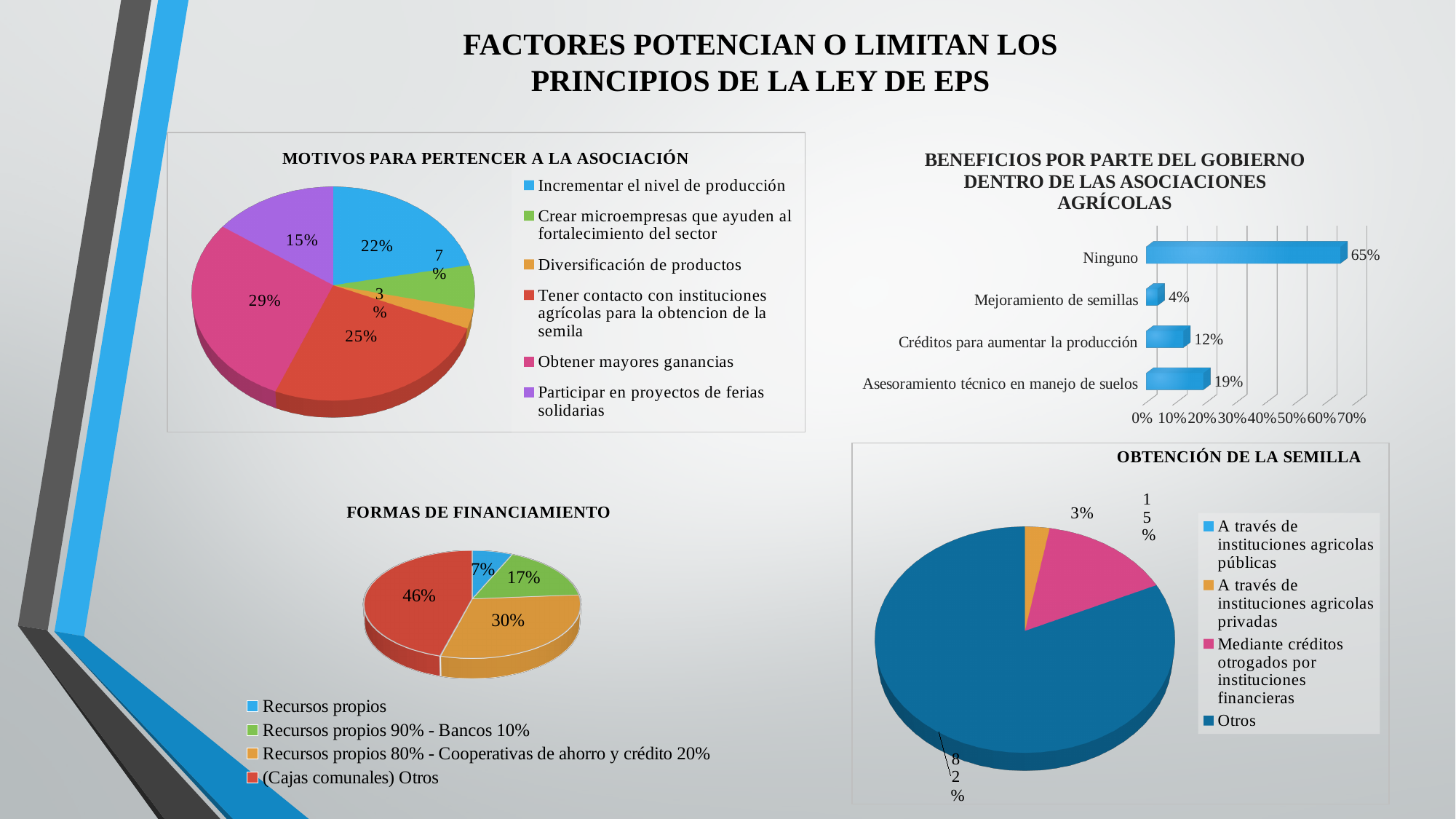
In the 'BENEFICIOS POR PARTE DEL GOBIERNO' chart, what is the value for 'Ninguno'? 65% In the 'MOTIVOS PARA PERTENCER A LA ASOCIACIÓN' chart, what is the difference between the shares for 'Incrementar el nivel de producción' and 'Participar en proyectos de ferias solidarias'? 7% In the 'OBTENCIÓN DE LA SEMILLA' chart, what percentage is shown for 'Otros'? 82% In the 'BENEFICIOS POR PARTE DEL GOBIERNO' chart, which is larger: 'Créditos para aumentar la producción' or 'Asesoramiento técnico en manejo de suelos'? Asesoramiento técnico en manejo de suelos In the 'BENEFICIOS POR PARTE DEL GOBIERNO' chart, how many categories are shown? 4 What kind of chart is the 'BENEFICIOS POR PARTE DEL GOBIERNO' chart? Bar chart In the 'MOTIVOS PARA PERTENCER A LA ASOCIACIÓN' chart, which motive has the smallest share? Diversificación de productos In the 'BENEFICIOS POR PARTE DEL GOBIERNO' chart, which category has the lowest value? Mejoramiento de semillas In the 'MOTIVOS PARA PERTENCER A LA ASOCIACIÓN' chart, how many entries does the legend list? 6 In the 'MOTIVOS PARA PERTENCER A LA ASOCIACIÓN' chart, what percentage is shown for 'Obtener mayores ganancias'? 29% In the 'FORMAS DE FINANCIAMIENTO' chart, what percentage is shown for 'Recursos propios 80% - Cooperativas de ahorro y crédito 20%'? 30% In the 'FORMAS DE FINANCIAMIENTO' chart, which financing form has the largest share? (Cajas comunales) Otros